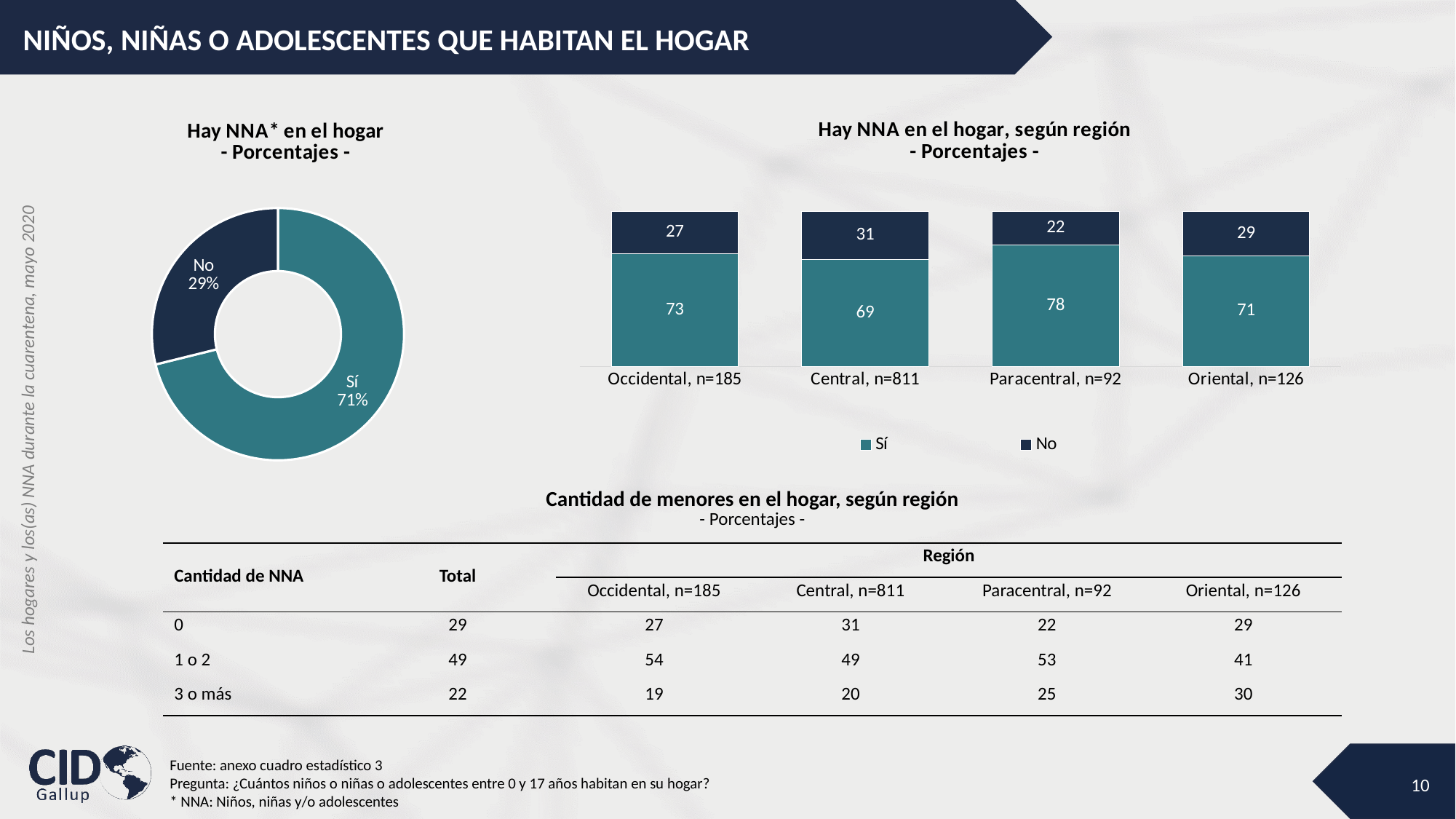
In the 'Hay NNA en el hogar, según región' chart, is the Sí value larger for Occidental, n=185 or Oriental, n=126? Occidental, n=185 In the 'Hay NNA en el hogar, según región' chart, what is the No value for Central, n=811? 31 In the 'Hay NNA* en el hogar' donut chart, what percentage answered No? 29% In the 'Hay NNA en el hogar, según región' chart, what is the Sí value for Paracentral, n=92? 78 What kind of chart is 'Hay NNA* en el hogar'? Donut (pie) chart How many regions are shown in the 'Hay NNA en el hogar, según región' chart? 4 In the 'Hay NNA* en el hogar' donut chart, what percentage answered Sí? 71% In the 'Hay NNA en el hogar, según región' chart, which region has the highest Sí value? Paracentral, n=92 In the 'Hay NNA en el hogar, según región' chart, which region has the lowest No value? Paracentral, n=92 What kind of chart is 'Hay NNA en el hogar, según región'? Stacked bar chart How many series does the legend of the 'Hay NNA en el hogar, según región' chart list? 2 In the 'Hay NNA en el hogar, según región' chart, what is the difference between the Sí values for Paracentral, n=92 and Central, n=811? 9